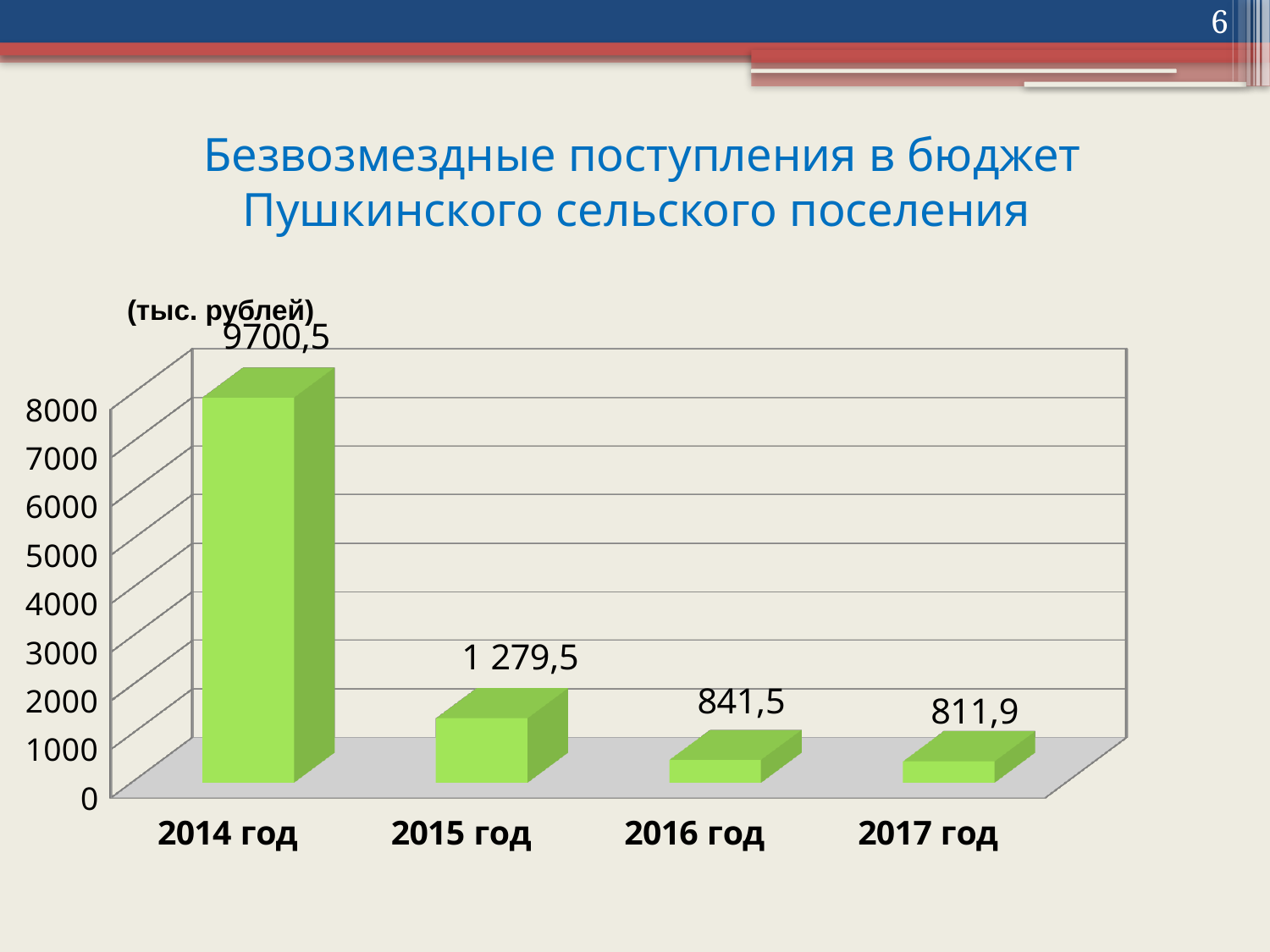
What is the value for 2015 год? 1 279,5 What is the value for 2016 год? 841,5 Which is larger, the value for 2016 год or the value for 2017 год? 2016 год What is the difference between the values for 2016 год and 2017 год? 29,6 How many years are shown on the chart? 4 What is the value for 2017 год? 811,9 Which year has the lowest value? 2017 год Which year has the highest value? 2014 год Do the values rise or fall from 2014 год to 2017 год? fall Is the value for 2015 год greater or less than 1000? greater What is the value for 2014 год? 9700,5 What is the difference between the values for 2014 год and 2015 год? 8421